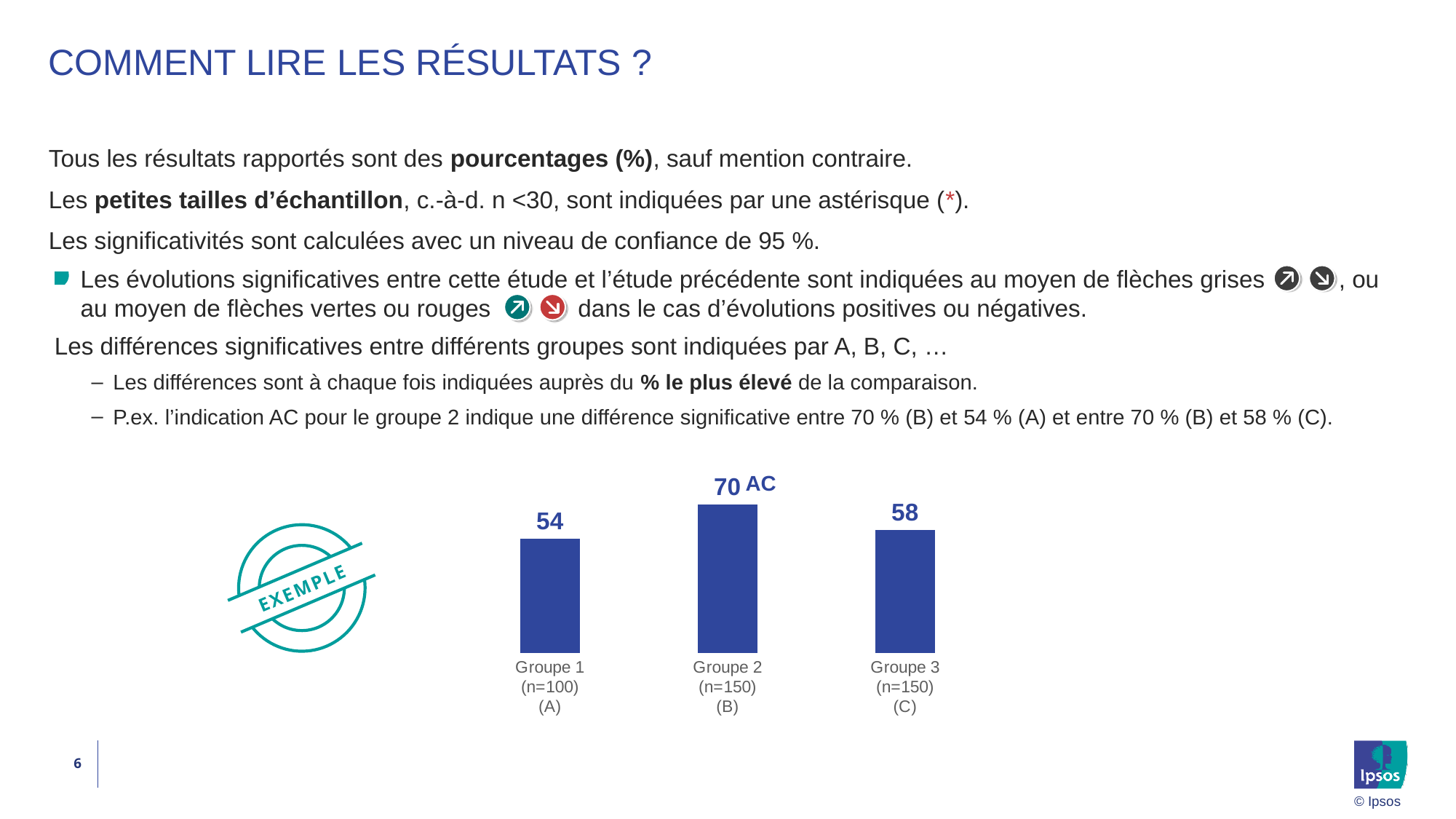
What is the sample size (n) shown for Groupe 1? n=100 Which has a larger value, Groupe 3 or Groupe 1? Groupe 3 Which group has the highest value in the chart? Groupe 2 How many groups are plotted in the chart? 3 Which letters are shown next to the value for Groupe 2 to indicate significant differences? AC What kind of chart is shown on the slide? Bar chart What is the value shown for Groupe 3 (n=150) (C)? 58 Which group has the lowest value in the chart? Groupe 1 What is the difference between the values for Groupe 2 and Groupe 1? 16 What is the value shown for Groupe 1 (n=100) (A)? 54 What is the difference between the values for Groupe 3 and Groupe 1? 4 What is the value shown for Groupe 2 (n=150) (B)? 70